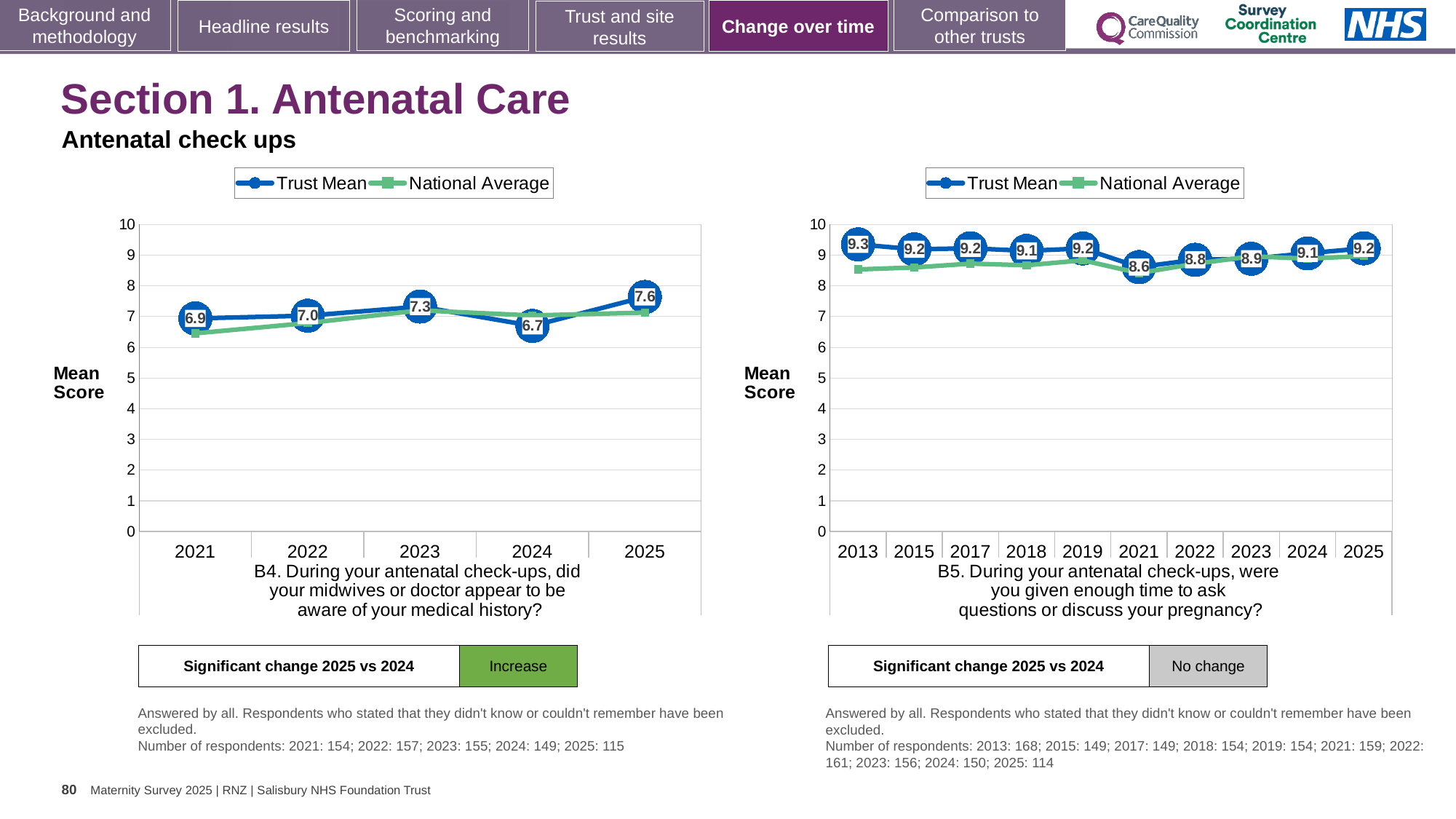
In the right chart (B5), how many years are shown on the x axis? 10 In the left chart (B4), which year has the highest Trust Mean? 2025 In the left chart (B4), which year has the lowest Trust Mean? 2024 In the left chart (B4), is the National Average for 2021 greater or less than 7? less In the left chart (B4), what is the Trust Mean for 2024? 6.7 In the right chart (B5), which year has the lowest Trust Mean? 2021 In the left chart (B4), what is the Trust Mean for 2025? 7.6 In the left chart (B4), what is the difference between the Trust Mean in 2025 and in 2024? 0.9 In the right chart (B5), what is the Trust Mean for 2013? 9.3 In the right chart (B5), is the Trust Mean for 2023 larger or smaller than the Trust Mean for 2025? smaller In the right chart (B5), what is the Trust Mean for 2021? 8.6 What type of chart is used on the left (B4)? Line chart